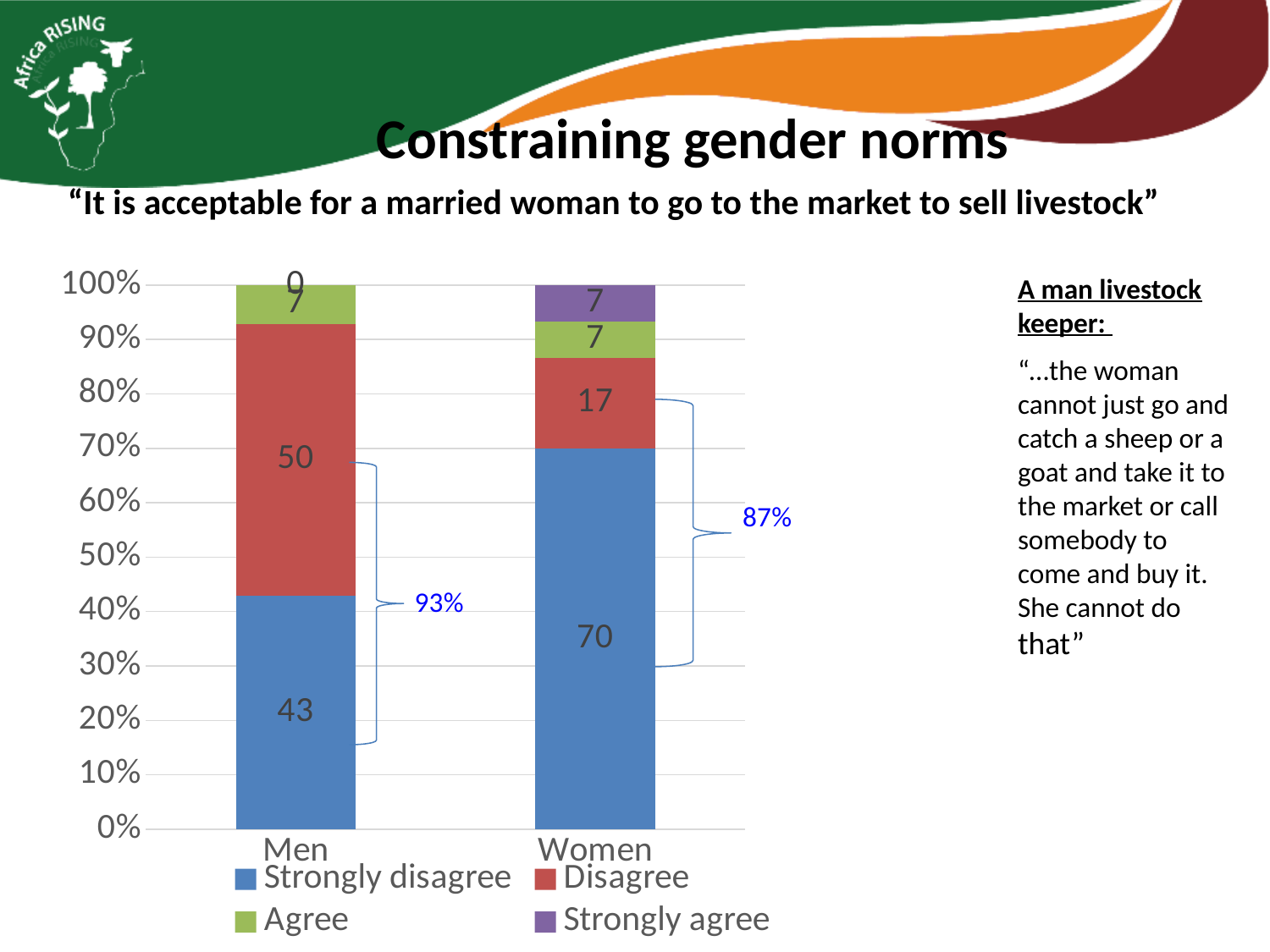
What is the Disagree value for Women? 17 What is the Agree value for Women? 7 What is the Strongly disagree value for Men? 43 What is the difference between the Disagree values for Men and Women? 33 How many categories are shown on the x axis? 2 How many series does the legend list? 4 Which category has the higher Strongly disagree value, Men or Women? Women What is the combined Strongly disagree and Disagree value for Men, as annotated on the chart? 93% What is the combined Strongly disagree and Disagree value for Women, as annotated on the chart? 87% What is the Strongly agree value for Men? 0 Which legend entry is shown in purple? Strongly agree What kind of chart is shown on the slide? Stacked bar chart